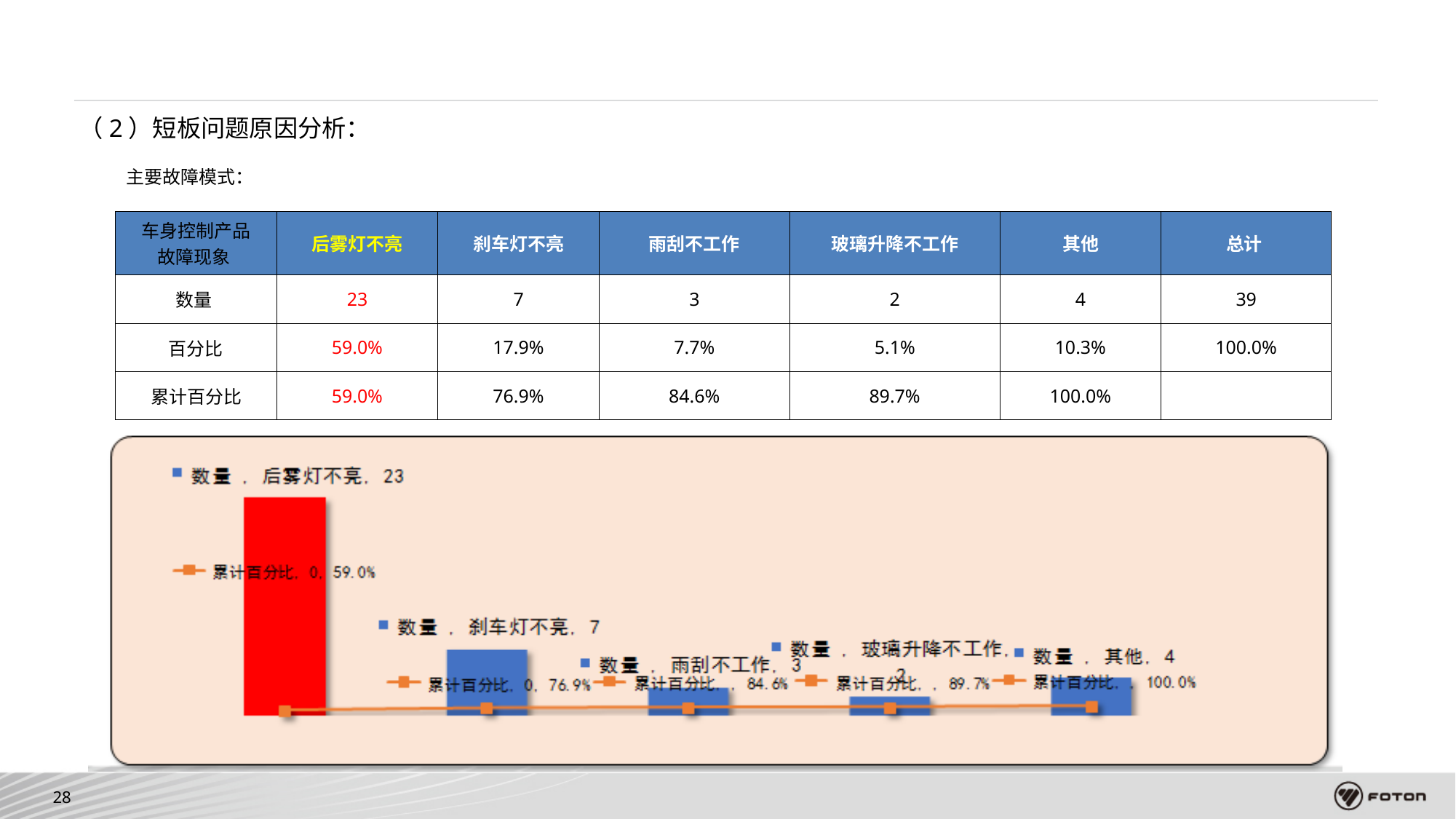
Which has a larger 数量 in the chart, 雨刮不工作 or 其他? 其他 Which category has the highest 数量 in the chart? 后雾灯不亮 What is the 累计百分比 value for 玻璃升降不工作 in the chart? 89.7% How many categories are plotted in the chart? 5 What colour is the bar for 后雾灯不亮 in the chart? red What is the difference in 数量 between 后雾灯不亮 and 刹车灯不亮 in the chart? 16 What is the 数量 value for 刹车灯不亮 in the chart? 7 What is the 数量 value for 后雾灯不亮 in the chart? 23 Does the 累计百分比 line rise or fall from left to right across the chart? rise How many data series does the chart show? 2 Which category has the lowest 数量 in the chart? 玻璃升降不工作 What is the 累计百分比 value for 雨刮不工作 in the chart? 84.6%